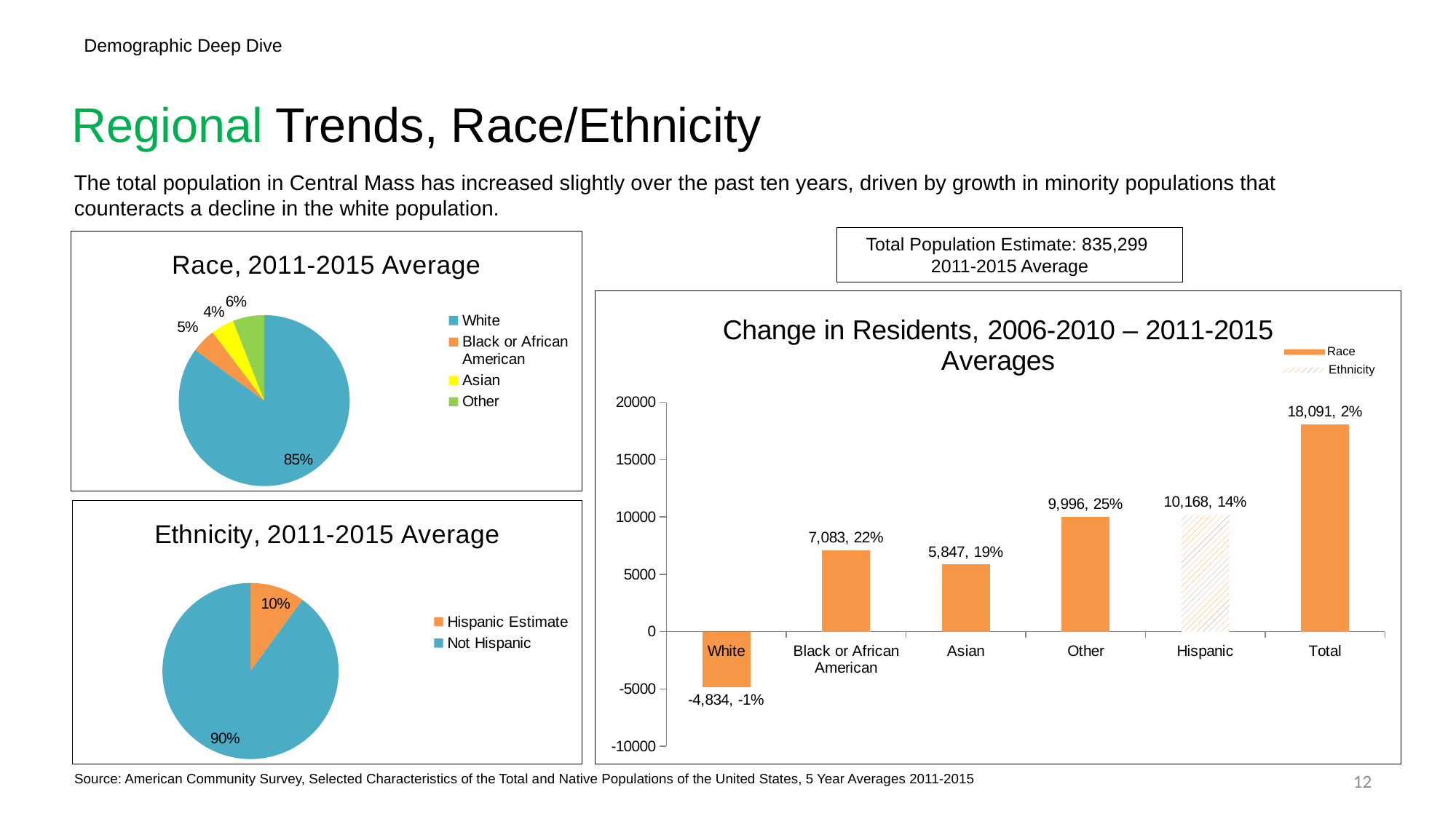
In the 'Ethnicity, 2011-2015 Average' pie chart, what share of the pie is Hispanic Estimate? 10% In the 'Change in Residents' bar chart, what is the difference between the values for Other and Asian? 4,149 What kind of chart is 'Change in Residents, 2006-2010 – 2011-2015 Averages'? Bar chart In the 'Race, 2011-2015 Average' pie chart, what share of the pie is White? 85% In the 'Ethnicity, 2011-2015 Average' pie chart, what share of the pie is Not Hispanic? 90% In the 'Change in Residents' bar chart, what is the change in residents for Hispanic? 10,168 In the 'Race, 2011-2015 Average' pie chart, which category has the smallest slice? Asian In the 'Race, 2011-2015 Average' pie chart, how many categories does the legend list? 4 In the 'Change in Residents' bar chart, how many series does the legend list? 2 In the 'Change in Residents' bar chart, which category has the highest value? Total In the 'Change in Residents' bar chart, what is the change in residents for White? -4,834